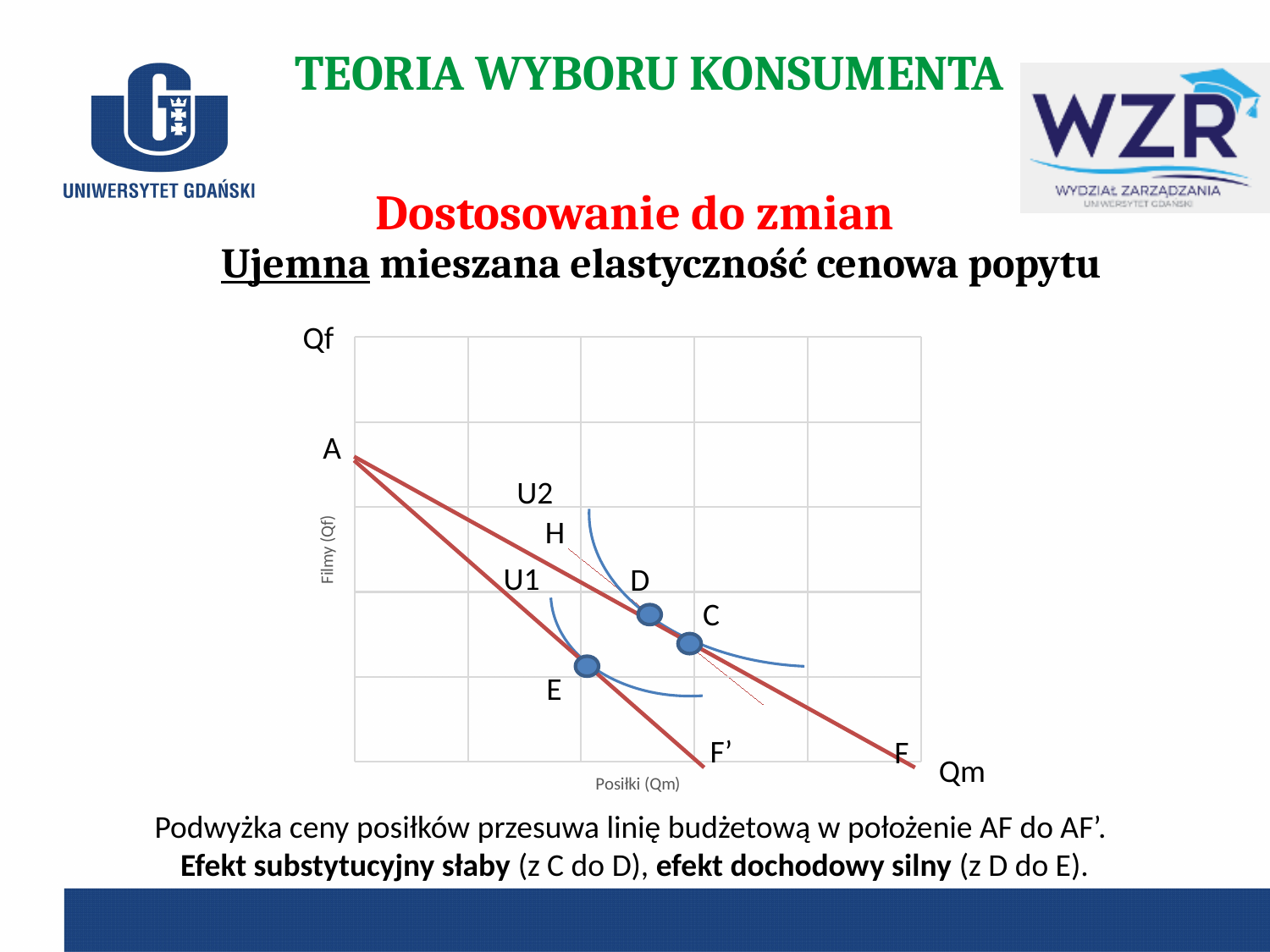
What is the label of the vertical axis of the chart? Filmy (Qf) Which of the marked points E, D and C lies lowest on the Qf (Filmy) axis? E Which of the marked points E, D and C lies highest on the Qf (Filmy) axis? D Which point has the larger Qf (Filmy) value, D or C? D Which budget line ends further to the right on the Qm axis, AF or AF'? AF Do the budget lines AF and AF' rise or fall as Qm increases along the x axis? fall What kind of chart is shown on the slide? line chart Which point has the larger Qm (Posiłki) value, C or E? C How many indifference curves (U1, U2) are drawn on the chart? 2 How many marked (dotted) points are shown on the chart? 3 What is the label of the horizontal axis of the chart? Posiłki (Qm)